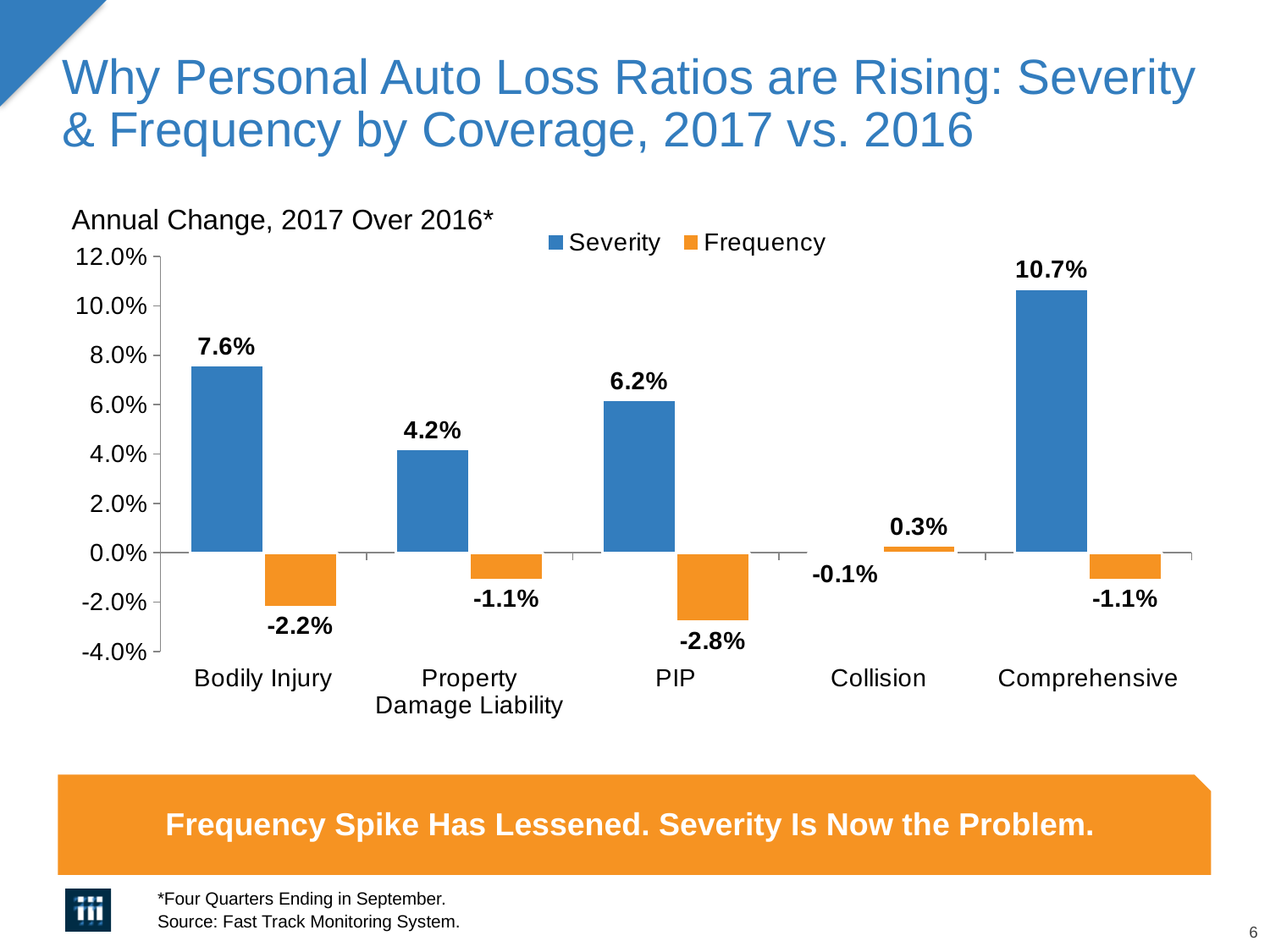
What is the Severity value for Property Damage Liability? 4.2% How many series does the legend list? 2 What is the Frequency value for PIP? -2.8% Which coverage has the highest Severity value? Comprehensive What kind of chart is shown on the slide? Bar chart How many coverage categories are shown on the x axis? 5 Which is larger, the Severity value for Bodily Injury or the Severity value for PIP? Bodily Injury What is the difference between the Severity values for Comprehensive and Bodily Injury? 3.1% What is the Severity value for Comprehensive? 10.7% What colour are the Frequency bars? Orange What is the Frequency value for Collision? 0.3% Which coverage has the lowest Frequency value? PIP